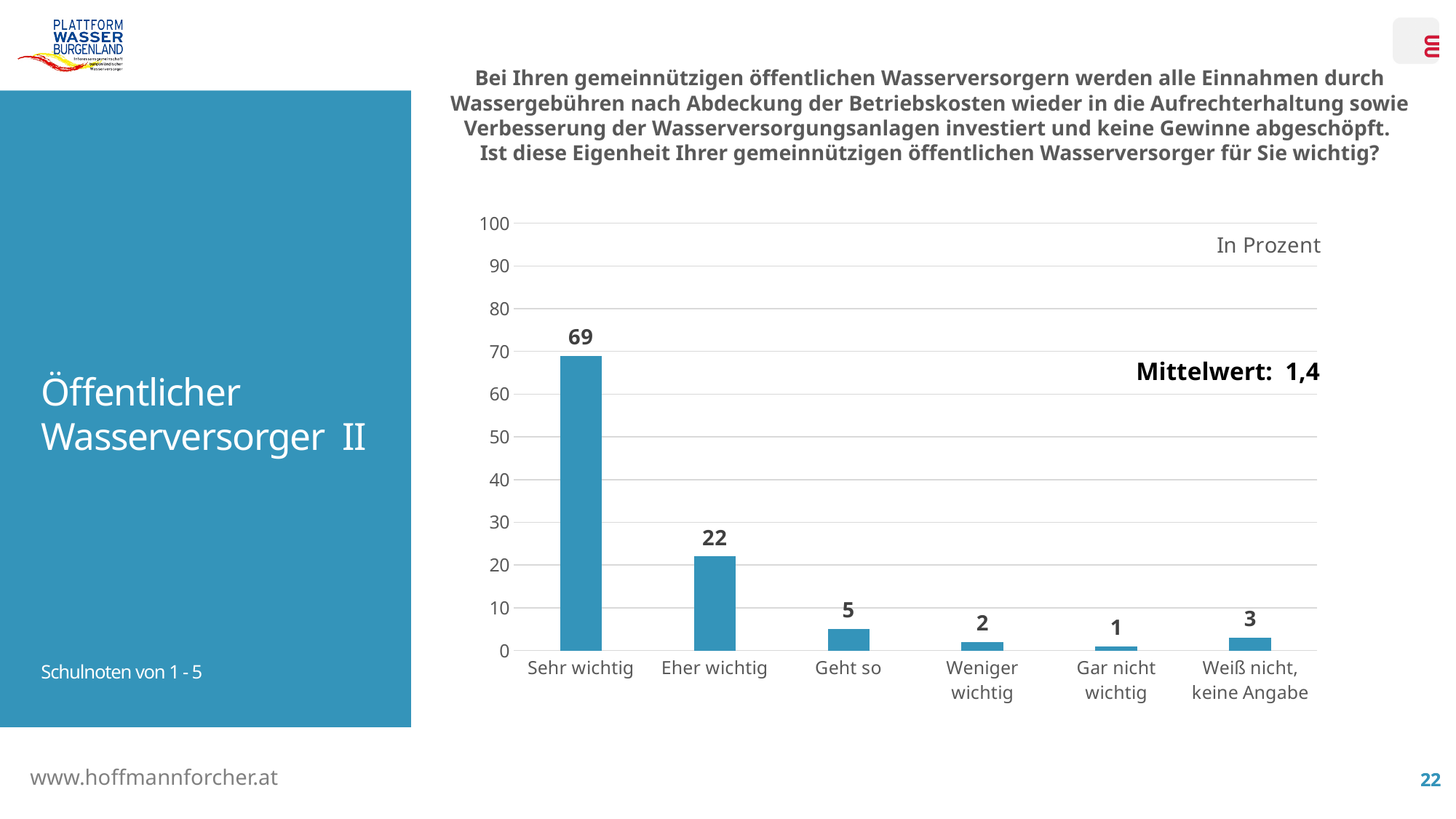
What is the value for "Sehr wichtig"? 69 Which category has the highest value? Sehr wichtig Is the value for "Sehr wichtig" greater or less than 60? greater What is the value for "Geht so"? 5 Which category has the lowest value? Gar nicht wichtig What kind of chart is shown on the slide? bar chart What is the value for "Eher wichtig"? 22 What is the difference between the values for "Sehr wichtig" and "Eher wichtig"? 47 What Mittelwert (mean value) is stated on the chart? 1,4 How many categories are shown on the x axis? 6 What is the value for "Weiß nicht, keine Angabe"? 3 Which is larger, the value for "Weniger wichtig" or the value for "Weiß nicht, keine Angabe"? Weiß nicht, keine Angabe